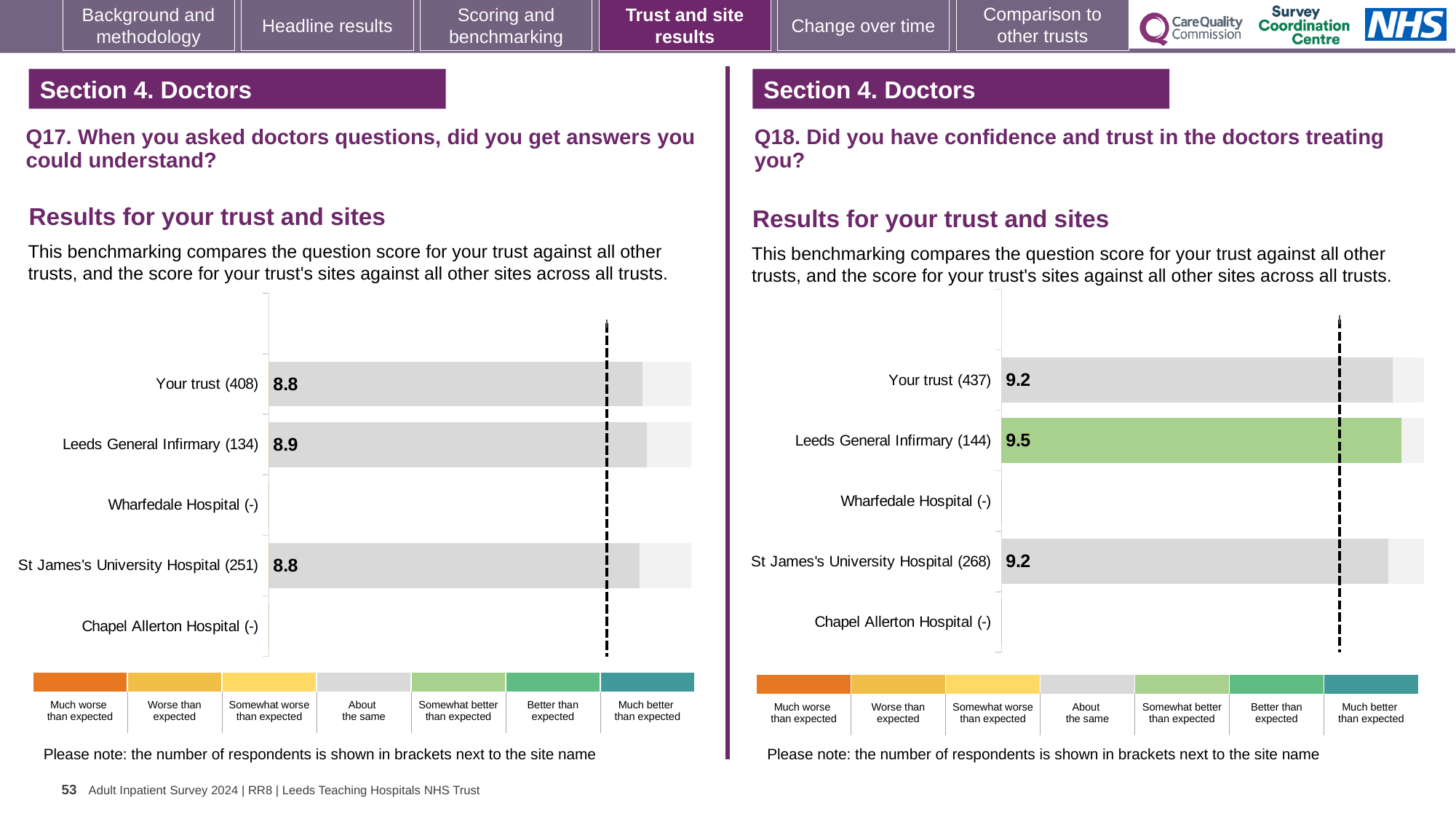
On the Q18 chart (right), which is larger: the score for Leeds General Infirmary or the score for St James's University Hospital? Leeds General Infirmary On the Q17 chart (left), what is the score for Leeds General Infirmary? 8.9 On the Q18 chart (right), how many rows show a plotted score? 3 On the Q18 chart (right), what is the difference between the Leeds General Infirmary score and the Your trust score? 0.3 On the Q18 chart (right), which site or trust row has the highest score? Leeds General Infirmary On the Q17 chart (left), what is the score for Your trust? 8.8 On the Q17 chart (left), what is the difference between the Leeds General Infirmary score and the St James's University Hospital score? 0.1 On the Q17 chart (left), how many rows (sites or trust) are listed on the vertical axis? 5 On the Q18 chart (right), how many respondents are shown in brackets for Your trust? 437 On the Q18 chart (right), what is the score for Leeds General Infirmary? 9.5 What type of chart is used on the Q17 chart (left)? Bar chart On the Q18 chart (right), what is the score for St James's University Hospital? 9.2